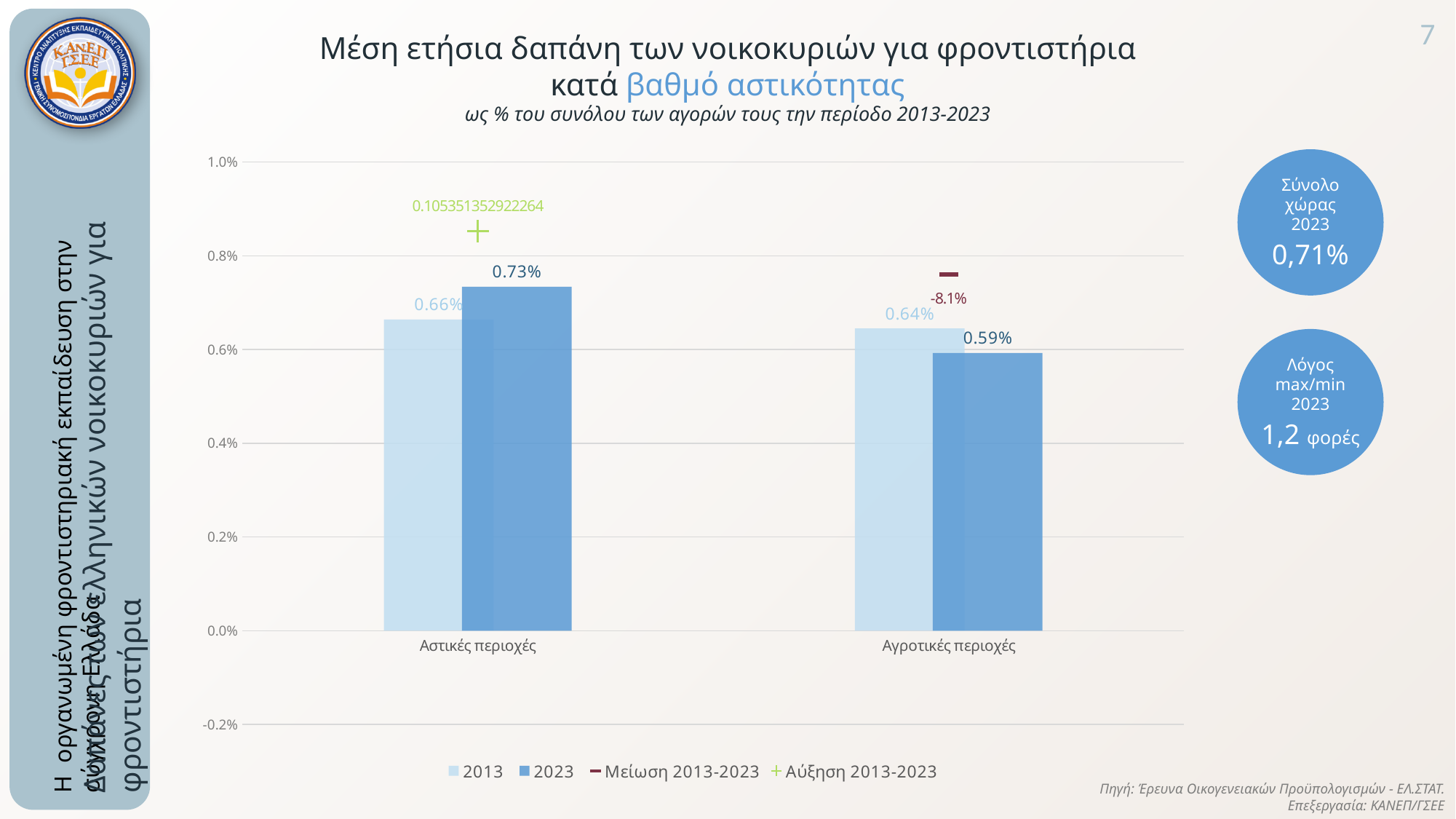
Which is larger for Αγροτικές περιοχές: the 2013 value or the 2023 value? 2013 What is the value for Αστικές περιοχές in 2023? 0.73% What is the value for Αγροτικές περιοχές in 2013? 0.64% What kind of chart is shown on the slide? bar chart What is the value for Αγροτικές περιοχές in 2023? 0.59% How many entries does the legend list? 4 What is the value for Αστικές περιοχές in 2013? 0.66% What is the difference between the 2023 values for Αστικές περιοχές and Αγροτικές περιοχές? 0.14% Which category has the highest 2023 value? Αστικές περιοχές How many categories are shown on the x axis? 2 Which category has the lowest 2023 value? Αγροτικές περιοχές Is the 2023 value for Αστικές περιοχές greater or less than 0.8%? less